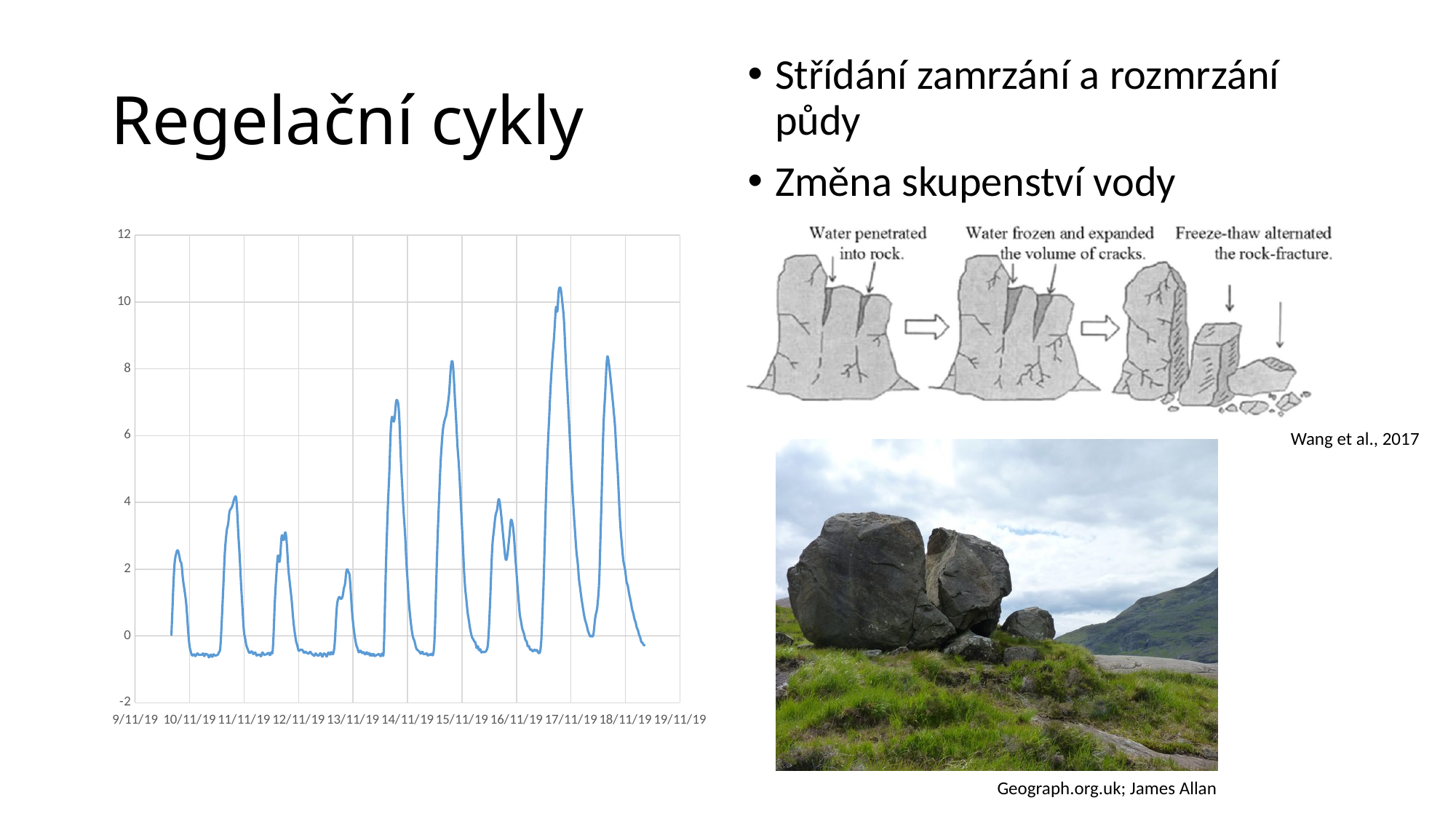
Which peak is higher: the one around 11/11/19 or the one around 12/11/19? 11/11/19 What is the highest value shown on the y axis of the line chart? 12 On which date does the line chart reach its highest peak? 16/11/19 Are the lowest values of the line between the peaks greater or less than 0? less How many date labels are shown on the x axis of the line chart? 11 What colour is the line in the chart? blue Is the peak value around 14/11/19 greater or less than 6? greater What kind of chart is shown on the left of the slide? line chart